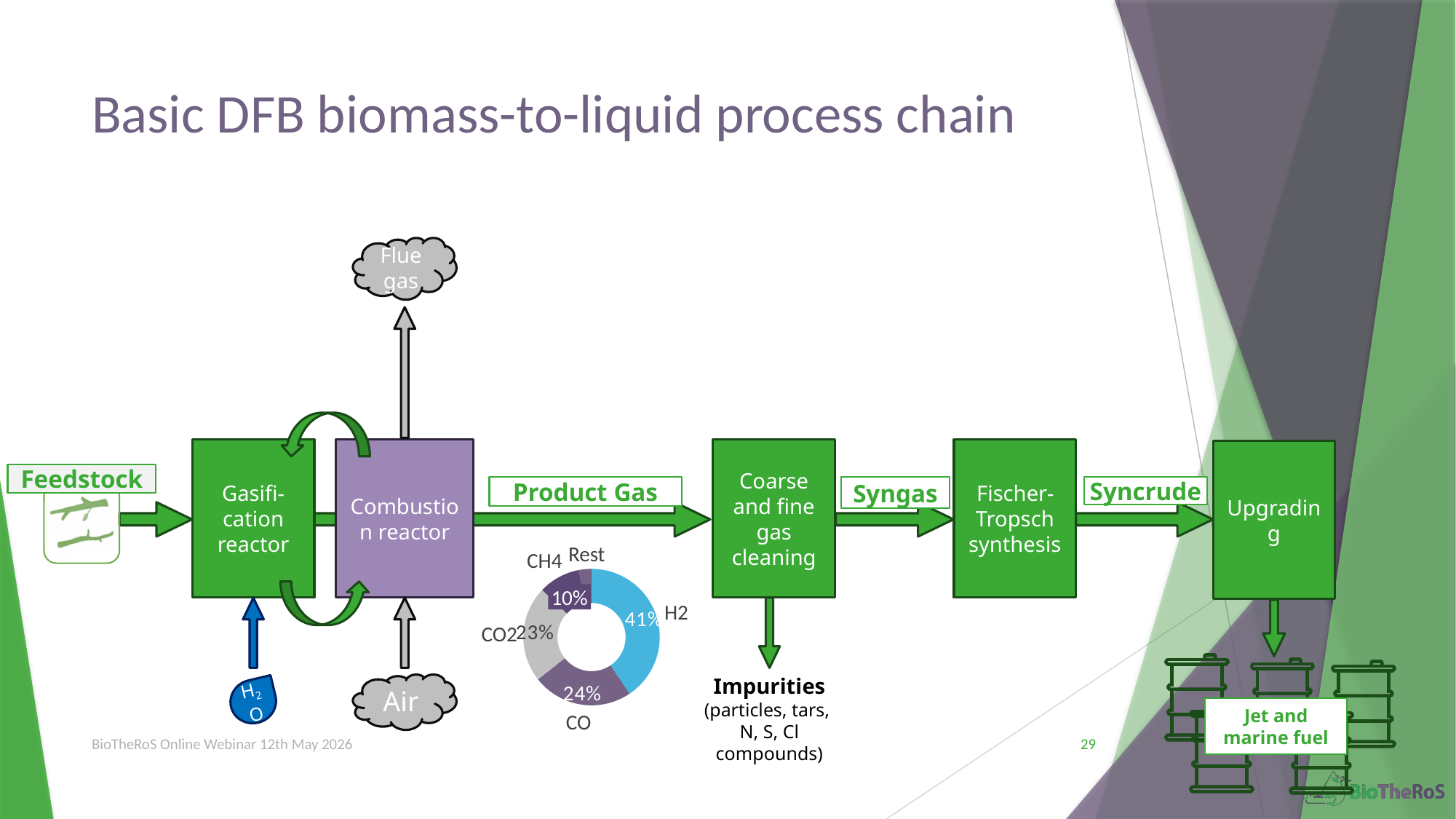
What kind of chart is shown below the Product Gas arrow? Doughnut chart In the product gas doughnut chart, which is larger: the share of CO or the share of CH4? CO In the product gas doughnut chart, what share is H2? 41% In the product gas doughnut chart, what share is CO2? 23% Which labelled component has the smallest share in the product gas doughnut chart, excluding Rest? CH4 In the product gas doughnut chart, what share is CH4? 10% In the product gas doughnut chart, what share is CO? 24% How many components are labelled in the product gas doughnut chart? 5 In the product gas doughnut chart, how much larger is the H2 share than the CO share? 17% In the product gas doughnut chart, what is the combined share of CO and CO2? 47% What colour is the H2 segment in the product gas doughnut chart? Blue Which component has the largest share in the product gas doughnut chart? H2